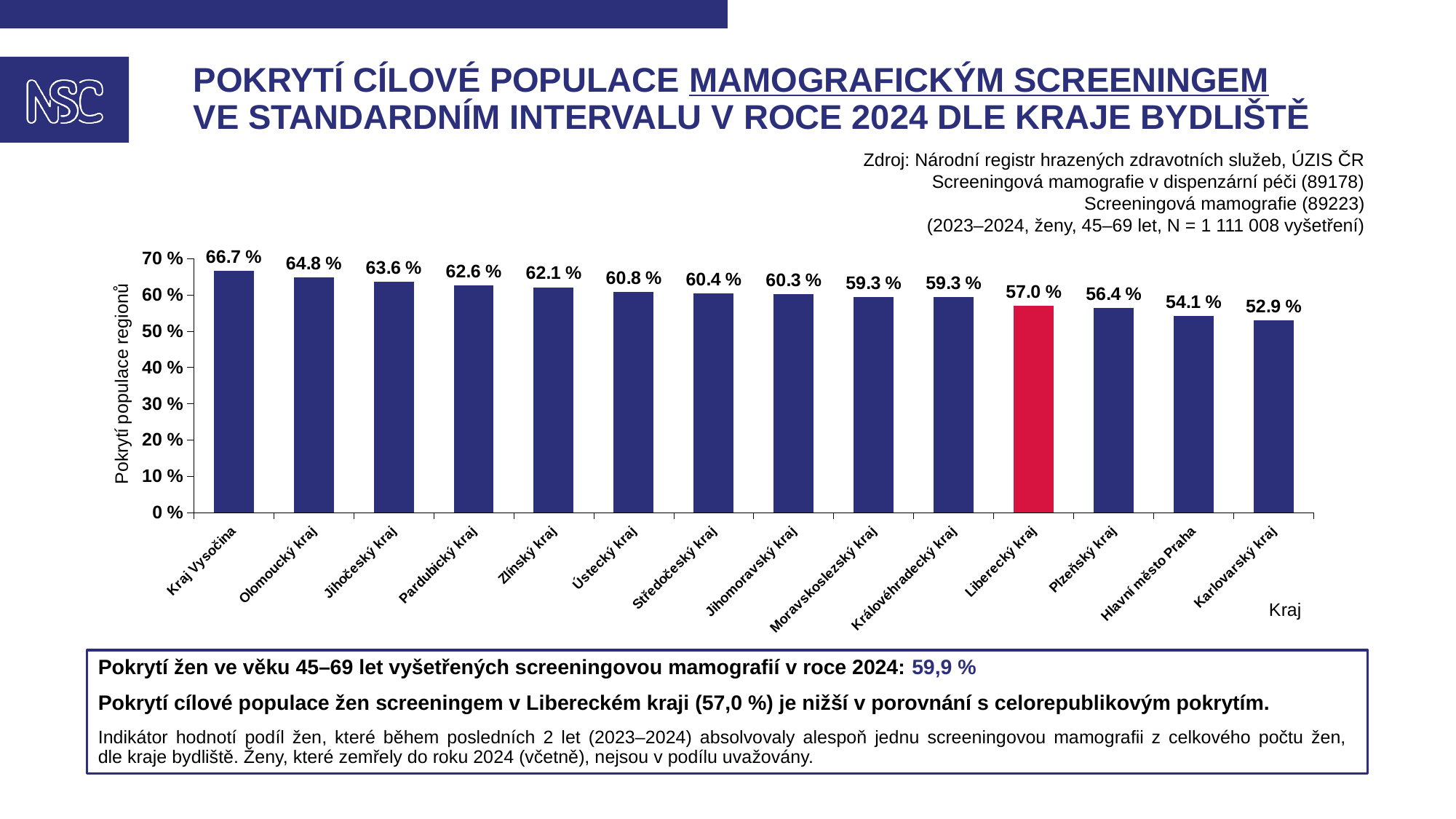
Which region has the highest value? Kraj Vysočina What is the value for Kraj Vysočina? 66.7 % Which has a larger value, Olomoucký kraj or Plzeňský kraj? Olomoucký kraj What is the value for Hlavní město Praha? 54.1 % How many regions are shown on the x axis? 14 Is the value for Ústecký kraj greater or less than 60 %? greater Which region's bar is highlighted in red? Liberecký kraj What is the difference between the values for Kraj Vysočina and Karlovarský kraj? 13.8 % Which region has the lowest value? Karlovarský kraj What kind of chart is shown on the slide? Bar chart Do the values rise or fall from left to right along the x axis? Fall What is the value for Liberecký kraj? 57.0 %